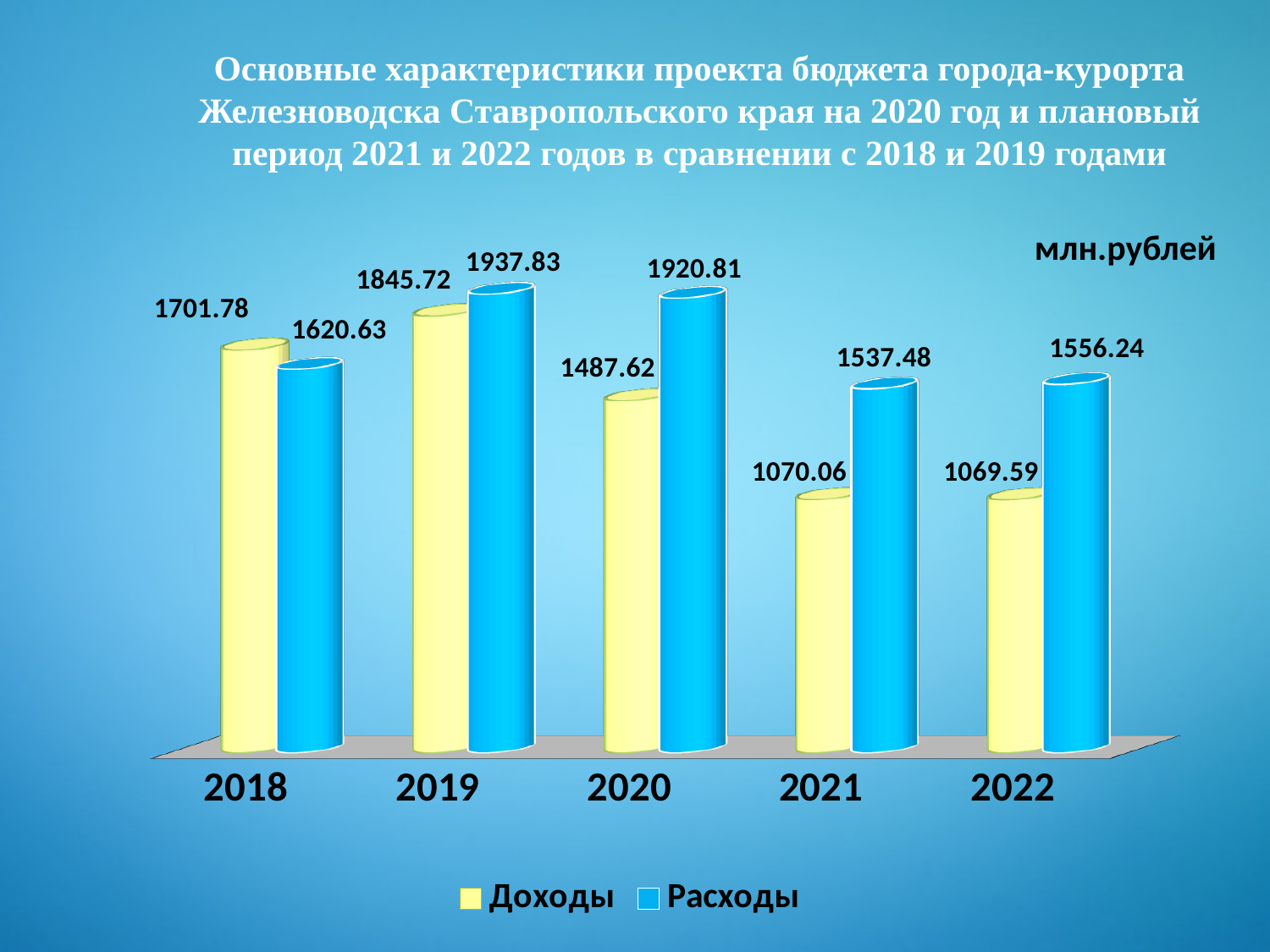
In 2020, which is larger: Доходы or Расходы? Расходы What is the value of Доходы for 2021? 1070.06 In which year is the value of Доходы the highest? 2019 In 2018, which is larger: Доходы or Расходы? Доходы What is the value of Расходы for 2022? 1556.24 What is the difference between Расходы and Доходы in 2021? 467.42 What is the value of Доходы for 2018? 1701.78 How many series does the legend list? 2 How many years are shown on the x axis of the chart? 5 What is the difference between Расходы and Доходы in 2019? 92.11 What kind of chart is shown on the slide? Bar chart What is the value of Расходы for 2020? 1920.81